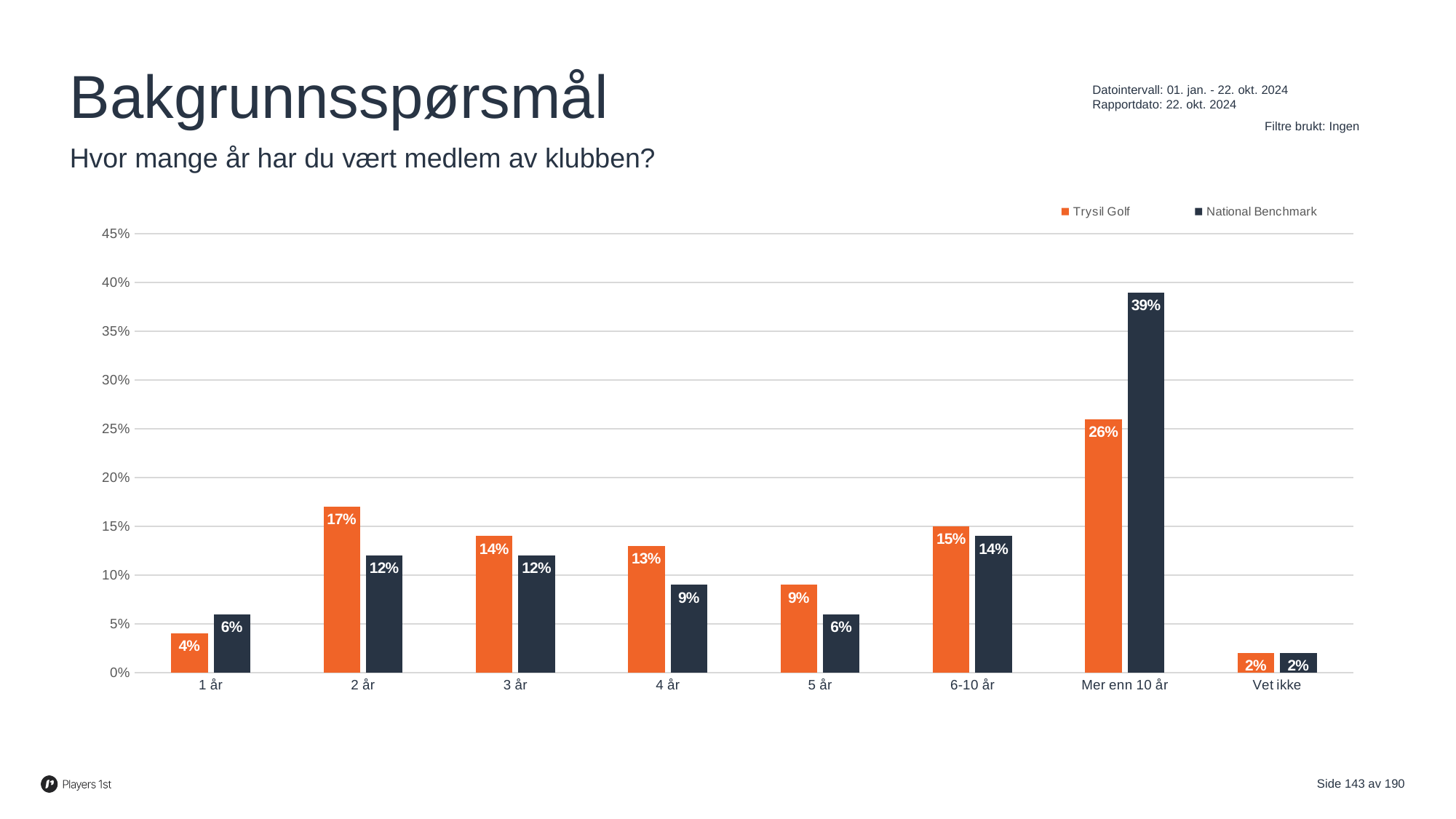
How many categories are shown on the x axis? 8 Which category has the highest Trysil Golf value? Mer enn 10 år How many series does the legend list? 2 Which category has the lowest National Benchmark value? Vet ikke What kind of chart is shown on the slide? Bar chart Which series is shown in orange? Trysil Golf What is the Trysil Golf value for "5 år"? 9% What is the Trysil Golf value for "2 år"? 17% What is the difference between the National Benchmark and Trysil Golf values for "Mer enn 10 år"? 13% What is the National Benchmark value for "Mer enn 10 år"? 39% Is the Trysil Golf value for "Mer enn 10 år" greater or less than 25%? greater Which is larger for "1 år": Trysil Golf or National Benchmark? National Benchmark